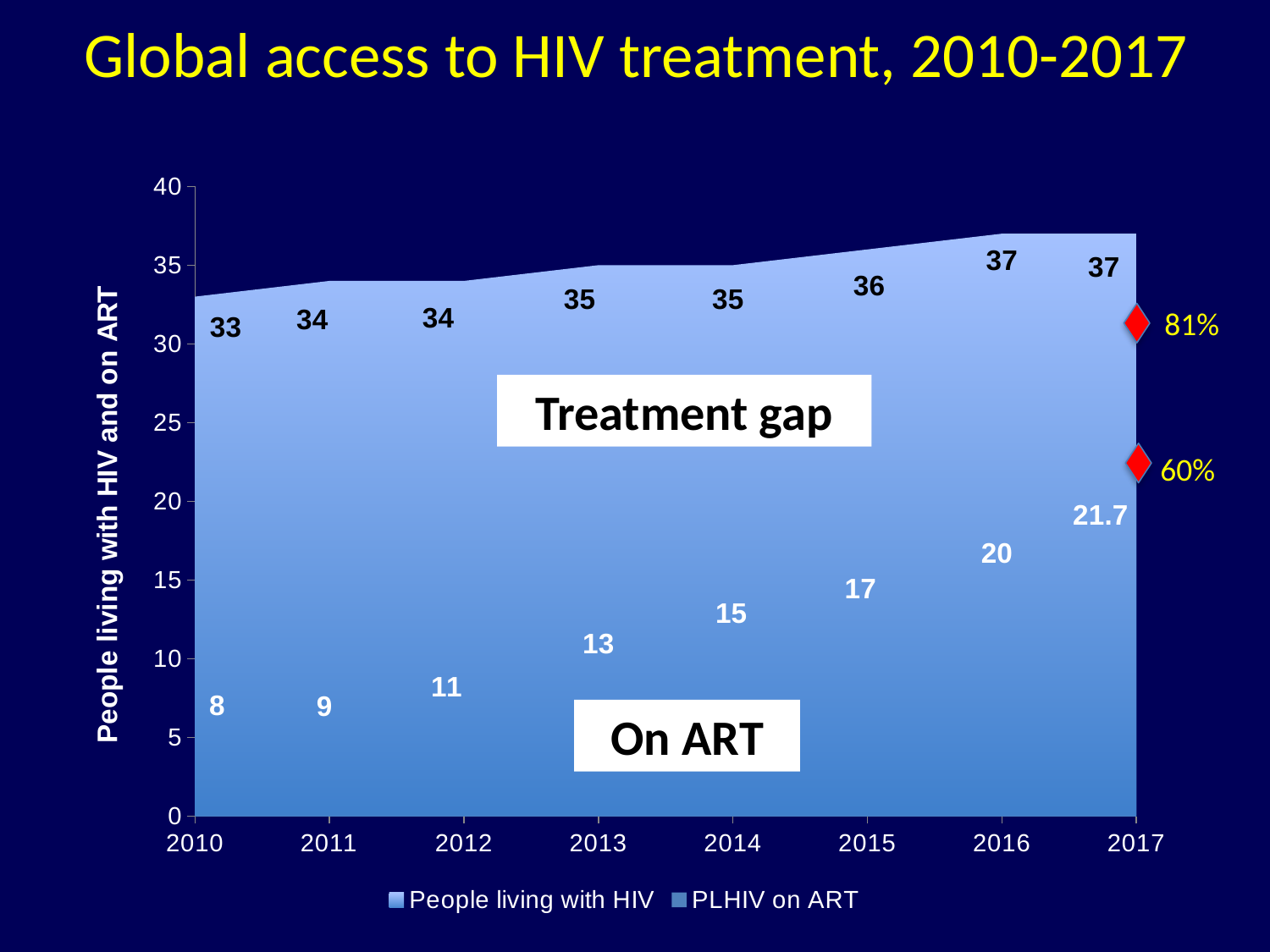
In which year is the PLHIV on ART value lowest? 2010 What is the value for People living with HIV in 2010? 33 Does the PLHIV on ART value rise or fall from 2010 to 2017? rise What is the title of the chart? Global access to HIV treatment, 2010-2017 What is the value for PLHIV on ART in 2017? 21.7 What is the value for PLHIV on ART in 2013? 13 What is the difference between the PLHIV on ART values in 2016 and 2010? 12 Which is larger, the PLHIV on ART value in 2015 or in 2012? 2015 How many years are shown on the x axis? 8 What kind of chart is shown on the slide? area chart What is the difference between People living with HIV and PLHIV on ART in 2017? 15.3 How many series does the legend list? 2